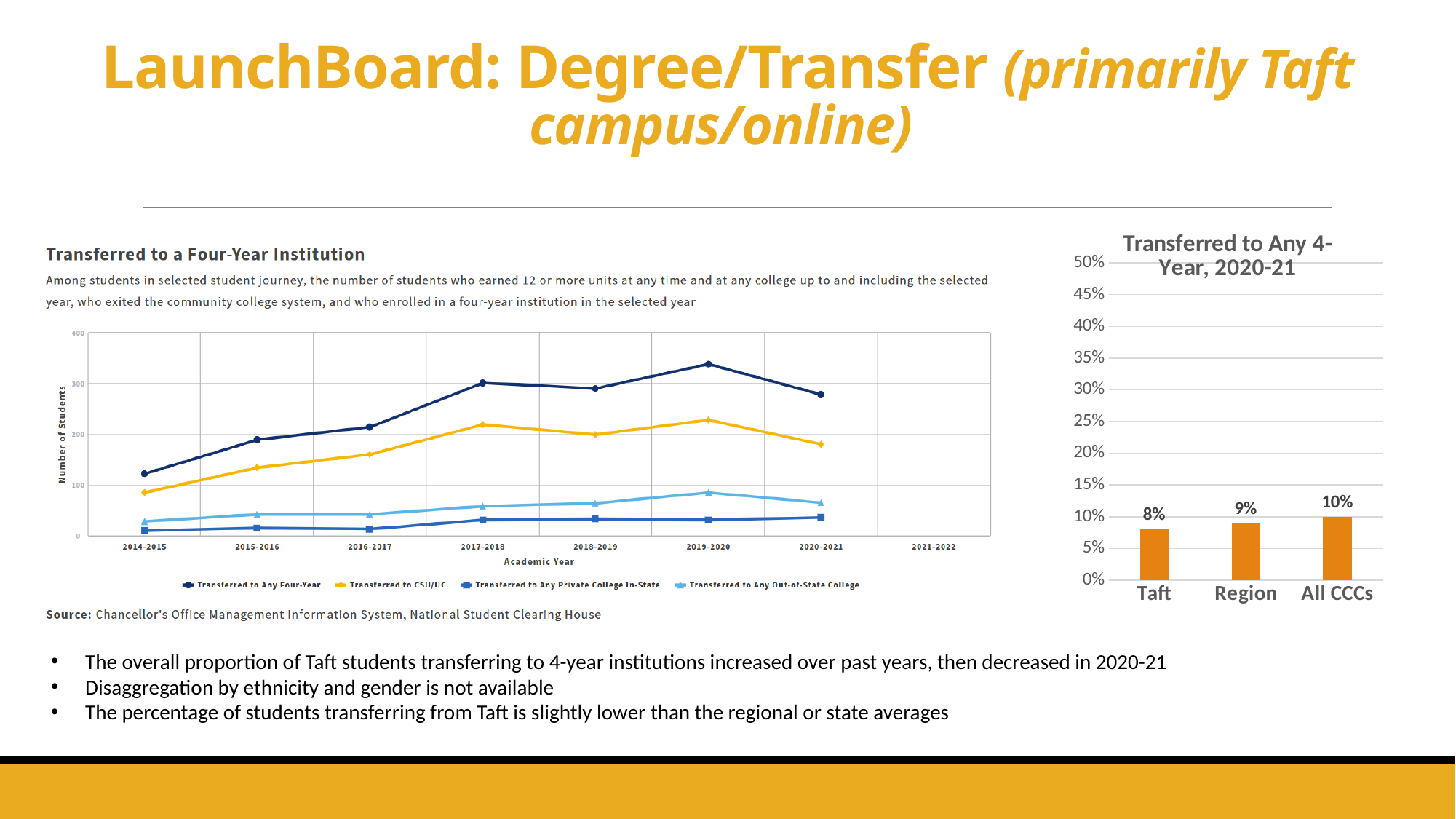
In the 'Transferred to a Four-Year Institution' chart, in which academic year does 'Transferred to Any Four-Year' reach its highest value? 2019-2020 In the 'Transferred to Any 4-Year, 2020-21' chart, which category has the lowest value? Taft In the 'Transferred to Any 4-Year, 2020-21' chart, what is the value for Taft? 8% In the 'Transferred to Any 4-Year, 2020-21' chart, what is the difference between the values for All CCCs and Taft? 2% In the 'Transferred to a Four-Year Institution' chart, is the value for 'Transferred to CSU/UC' in 2014-2015 greater or less than 100? less In the 'Transferred to Any 4-Year, 2020-21' chart, what is the value for All CCCs? 10% What kind of chart is 'Transferred to Any 4-Year, 2020-21'? Bar chart In the 'Transferred to Any 4-Year, 2020-21' chart, which category has the highest value? All CCCs What kind of chart is 'Transferred to a Four-Year Institution'? Line chart In the 'Transferred to a Four-Year Institution' chart, is the value for 'Transferred to Any Four-Year' in 2019-2020 greater or less than 300? greater In the 'Transferred to Any 4-Year, 2020-21' chart, how many categories are shown? 3 How many series does the legend of the 'Transferred to a Four-Year Institution' chart list? 4